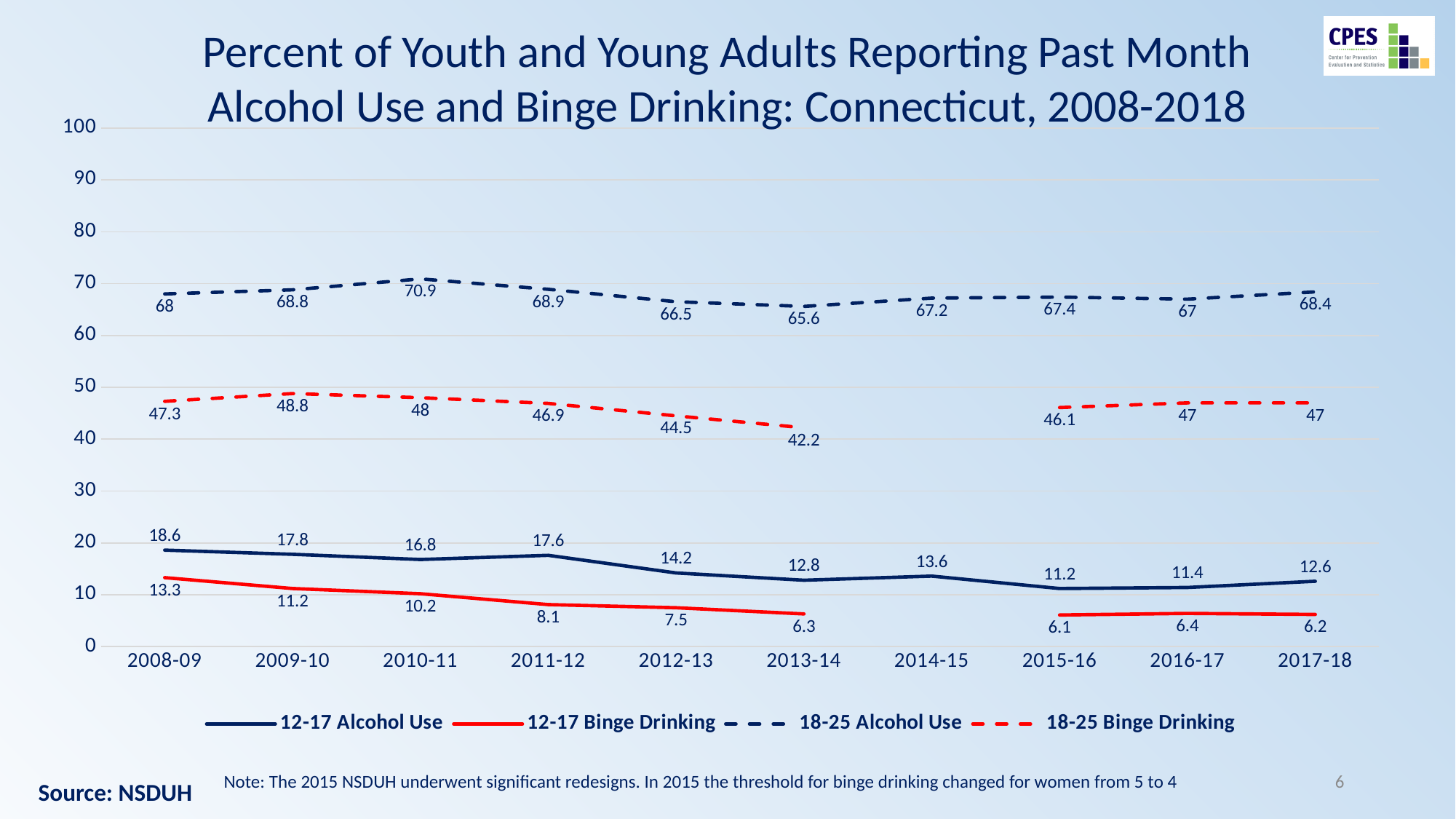
What is the value for 18-25 Binge Drinking in 2013-14? 42.2 Does 12-17 Binge Drinking rise or fall from 2008-09 to 2013-14? Fall In which period is 18-25 Alcohol Use highest? 2010-11 What kind of chart is shown on the slide? Line chart How many series does the legend list? 4 Which period has no data labels for the two binge drinking series? 2014-15 What is the value for 18-25 Alcohol Use in 2010-11? 70.9 What is the difference between 12-17 Binge Drinking in 2008-09 and in 2017-18? 7.1 What is the value for 12-17 Alcohol Use in 2008-09? 18.6 Which is larger for 18-25 Binge Drinking: the value in 2009-10 or the value in 2017-18? 2009-10 In which period is 12-17 Alcohol Use lowest? 2015-16 How many time periods are shown on the x axis? 10